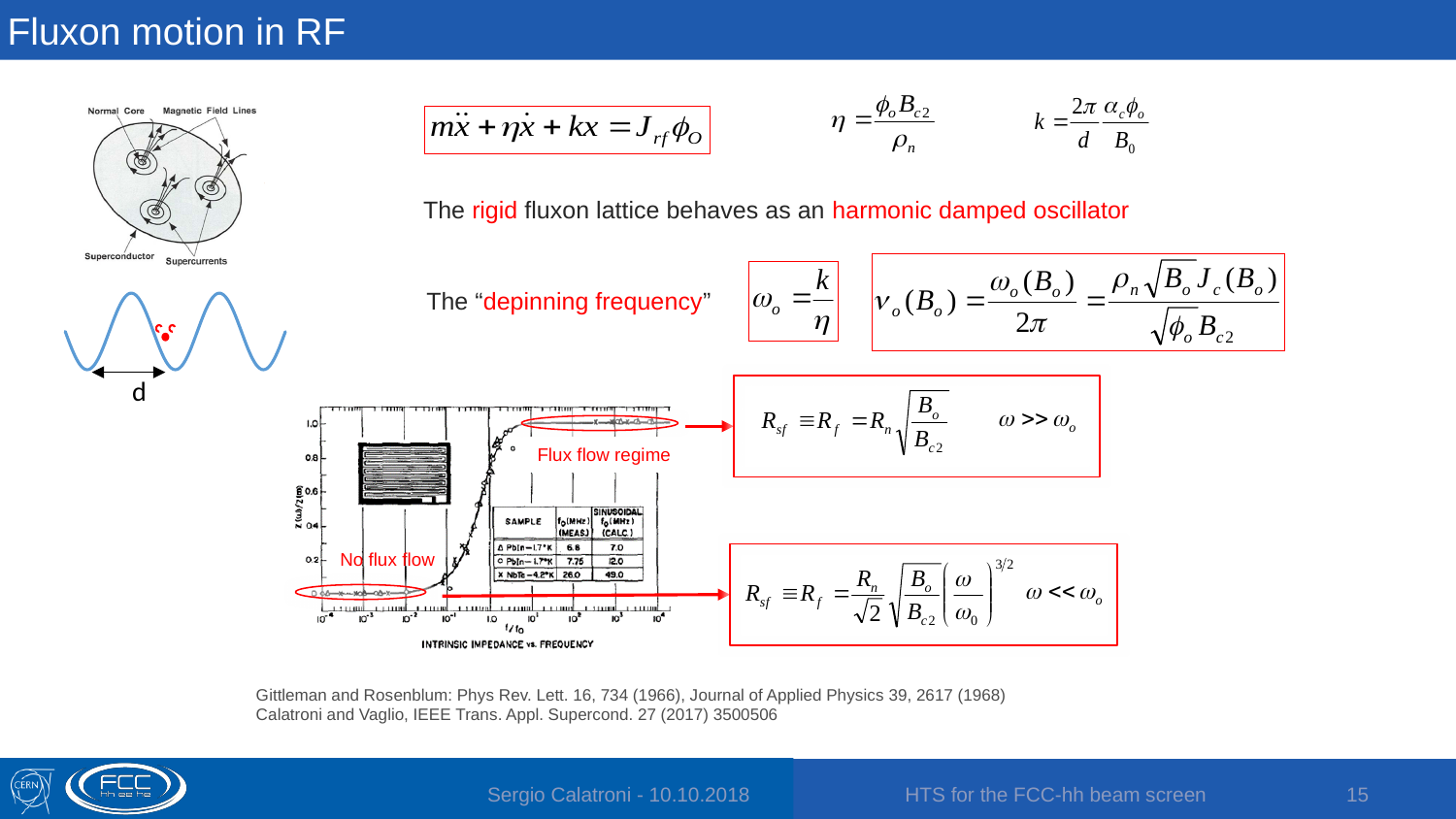
In the sample table of the plot, what is the measured f0 (MHz) for the PbIn-1.7°K sample marked with a triangle? 6.8 In the intrinsic impedance vs. frequency plot, do the values rise or fall as f/f0 increases? rise Is the plotted impedance ratio at f/f0 = 10^-2 greater or less than 0.2? less Is the plotted impedance ratio at f/f0 = 10^2 greater or less than 0.8? greater What is the highest tick value shown on the y axis of the intrinsic impedance plot? 1.0 What is the title printed beneath the plot on the slide? INTRINSIC IMPEDANCE vs. FREQUENCY What is the difference between the calculated and measured f0 (MHz) for NbTa-4.2°K in the plot's table? 23.0 What quantity is plotted on the x axis of the intrinsic impedance plot? f/f0 Which sample in the plot's table has the highest measured f0? NbTa-4.2°K How many samples are listed in the table inside the intrinsic impedance plot? 3 In the sample table of the plot, what is the calculated sinusoidal f0 (MHz) for NbTa-4.2°K? 49.0 In the sample table of the plot, what is the measured f0 (MHz) for NbTa-4.2°K? 26.0